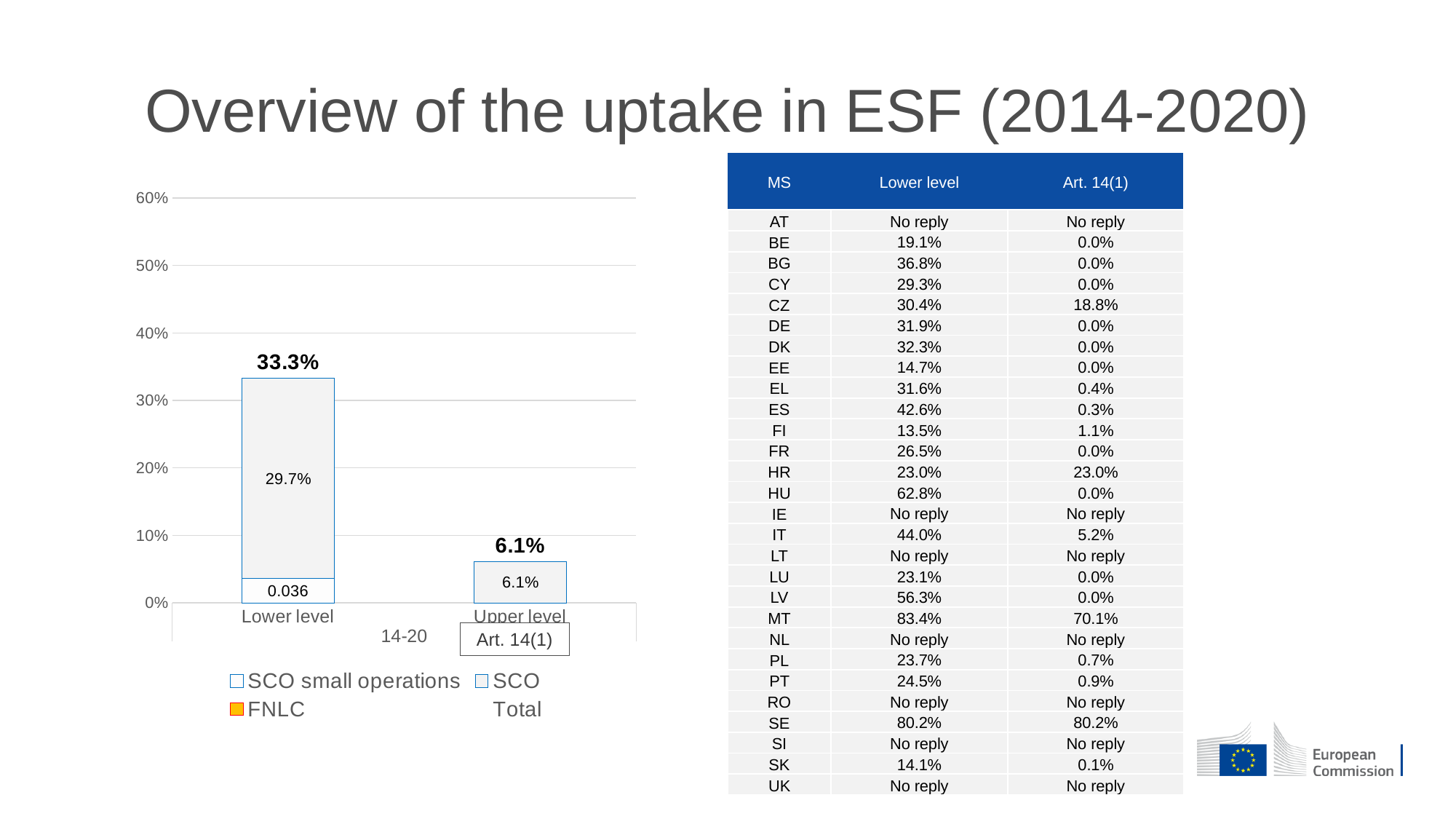
What is the highest value shown on the chart's y axis? 60% What is the SCO value for the Lower level bar? 29.7% How many entries does the chart legend list? 4 What is the difference between the Lower level total and the Upper level total? 27.2% What is the total value shown above the Upper level bar? 6.1% What is the total value shown above the Lower level bar? 33.3% What is the SCO small operations value for the Lower level bar? 0.036 Which category has the higher total, Lower level or Upper level? Lower level Is the total for Lower level greater or less than 30%? greater Is the total for Upper level greater or less than 10%? less What kind of chart is shown on the slide? bar chart How many categories are plotted on the x axis of the chart? 2